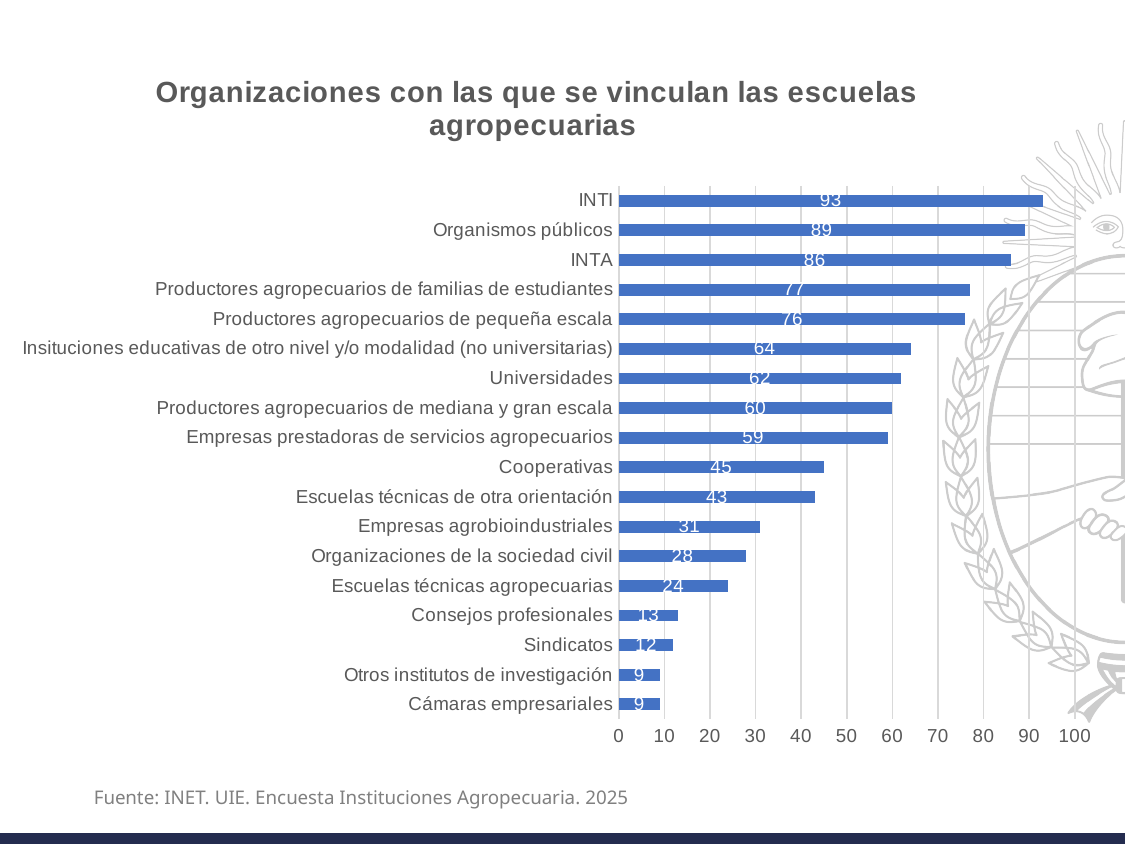
What is the value for Cooperativas? 45 What is the value for Escuelas técnicas agropecuarias? 24 What is the value for INTI? 93 What is the difference between the values for Universidades and Empresas agrobioindustriales? 31 How many categories are shown in the chart? 18 What is the value for Sindicatos? 12 What is the difference between the values for Organismos públicos and INTA? 3 What is the title of the chart? Organizaciones con las que se vinculan las escuelas agropecuarias Which is larger, the value for Cooperativas or the value for Organizaciones de la sociedad civil? Cooperativas Which category has the highest value? INTI What kind of chart is shown on the slide? Bar chart Is the value for Productores agropecuarios de pequeña escala greater or less than 70? greater